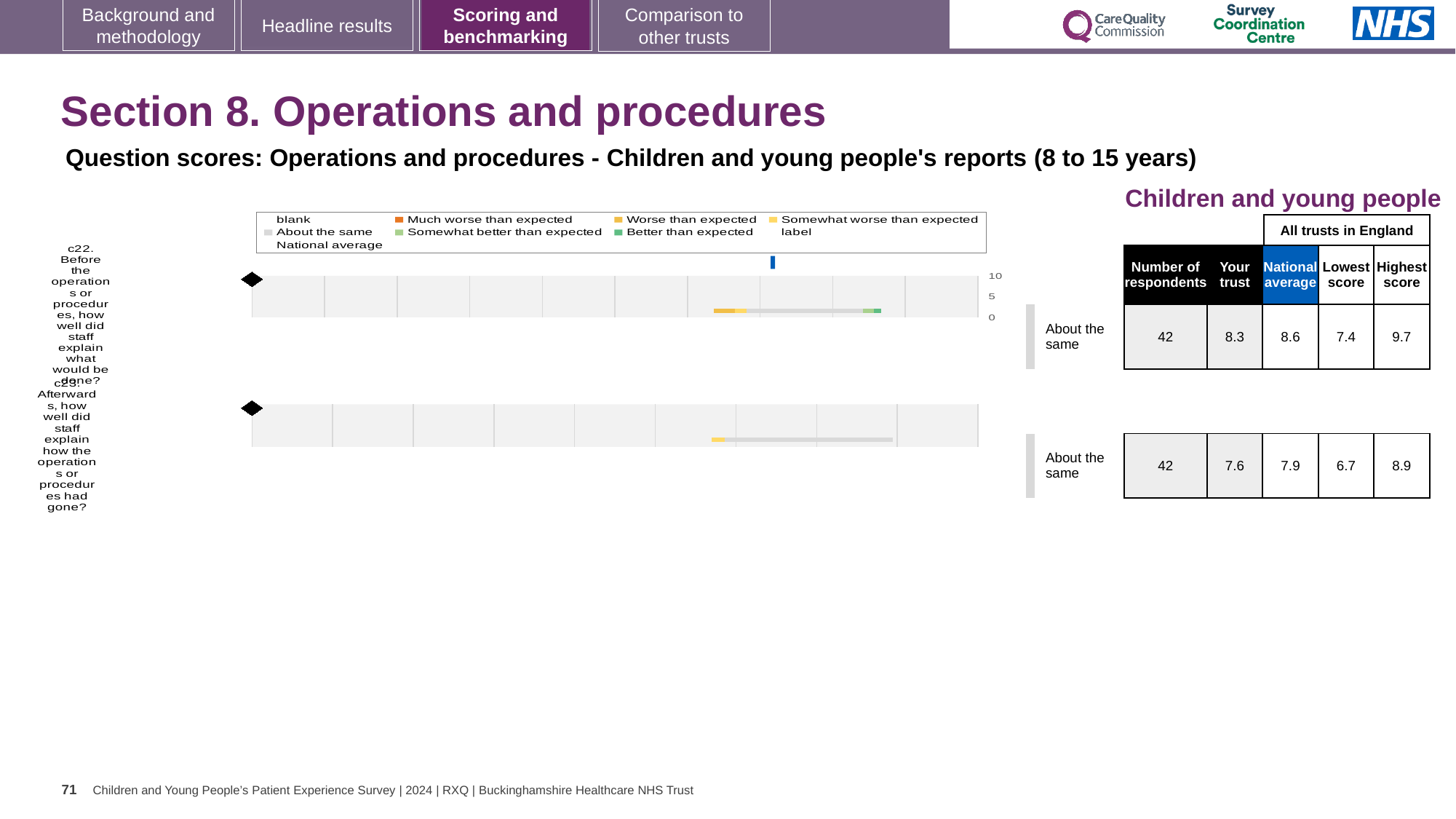
What is the lowest score among all trusts in England for question c23? 6.7 What is the 'Your trust' score for question c22 (Before the operations or procedures, how well did staff explain what would be done?)? 8.3 How many questions are plotted in the chart? 2 Which legend entry is shown in orange? Much worse than expected What is the difference between the highest and lowest scores in England for question c23? 2.2 What benchmark category is shown for question c23? About the same Which question has the higher 'Your trust' score, c22 or c23? c22 What is the national average score for question c23 (Afterwards, how well did staff explain how the operations or procedures had gone?)? 7.9 What is the difference between the national average and the trust score for question c22? 0.3 What is the highest score among all trusts in England for question c22? 9.7 How many respondents answered question c22? 42 What kind of chart is used to show the question scores? Bar chart